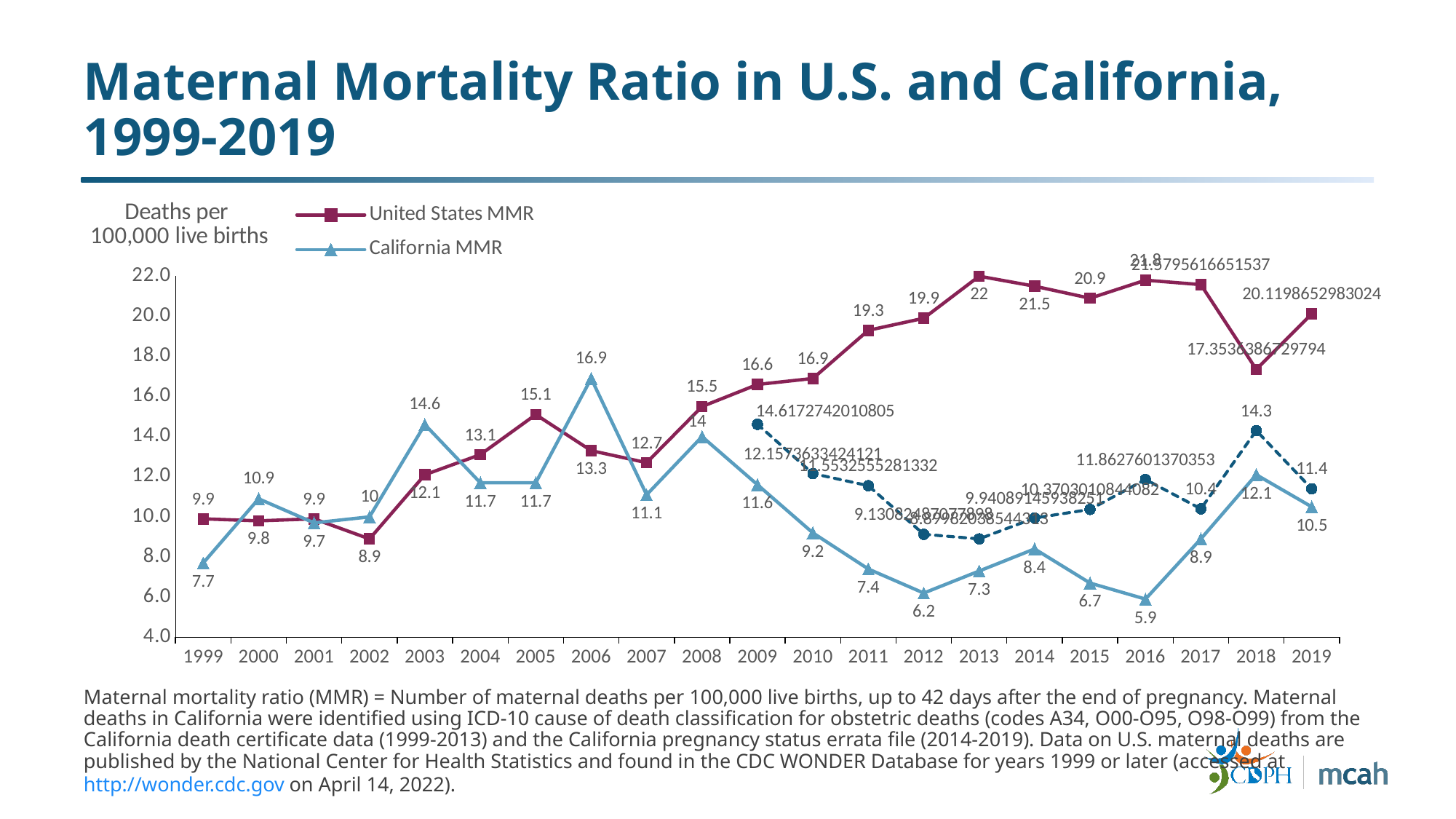
In which year is the California MMR lowest? 2016 In 2003, which is larger: the United States MMR or the California MMR? California MMR In which year is the United States MMR highest? 2013 What is the difference between the United States MMR and the California MMR in 2013? 14.7 What is the United States MMR value for 2013? 22 Is the United States MMR value for 2018 greater or less than 18.0? less What kind of chart is shown on the slide? line chart How many series does the legend list? 2 What is the label on the y axis of the chart? Deaths per 100,000 live births What is the California MMR value for 2006? 16.9 How many years are shown on the x axis? 21 What is the California MMR value for 2012? 6.2